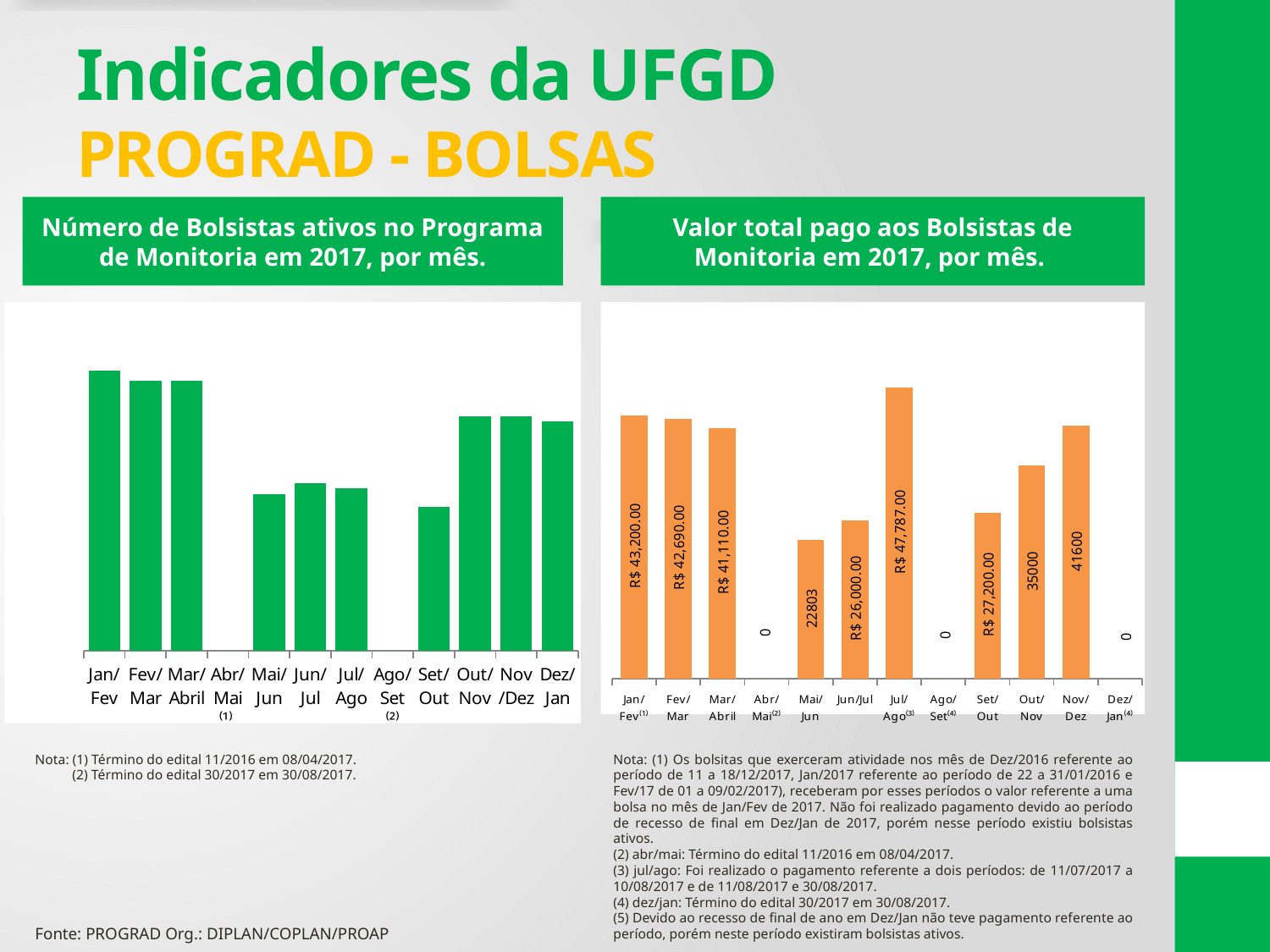
In the chart 'Valor total pago aos Bolsistas de Monitoria em 2017, por mês', which is larger, the value for Set/Out or the value for Jun/Jul? Set/Out In the chart 'Valor total pago aos Bolsistas de Monitoria em 2017, por mês', what is the value for Nov/Dez? 41600 In the chart 'Valor total pago aos Bolsistas de Monitoria em 2017, por mês', what is the difference between the values for Nov/Dez and Out/Nov? 6600 In the chart 'Valor total pago aos Bolsistas de Monitoria em 2017, por mês', what is the value for Mai/Jun? 22803 In the chart 'Valor total pago aos Bolsistas de Monitoria em 2017, por mês', what is the difference between the values for Jan/Fev and Fev/Mar? R$ 510.00 In the chart 'Número de Bolsistas ativos no Programa de Monitoria em 2017, por mês', which period has the highest bar? Jan/Fev In the chart 'Valor total pago aos Bolsistas de Monitoria em 2017, por mês', which period has the highest value? Jul/Ago What kind of chart is 'Número de Bolsistas ativos no Programa de Monitoria em 2017, por mês'? Bar chart In the chart 'Número de Bolsistas ativos no Programa de Monitoria em 2017, por mês', which is larger, the bar for Set/Out or the bar for Out/Nov? Out/Nov In the chart 'Valor total pago aos Bolsistas de Monitoria em 2017, por mês', what is the value for Jan/Fev? R$ 43,200.00 How many periods are shown on the x axis of the chart 'Valor total pago aos Bolsistas de Monitoria em 2017, por mês'? 12 In the chart 'Valor total pago aos Bolsistas de Monitoria em 2017, por mês', what is the value for Jul/Ago? R$ 47,787.00